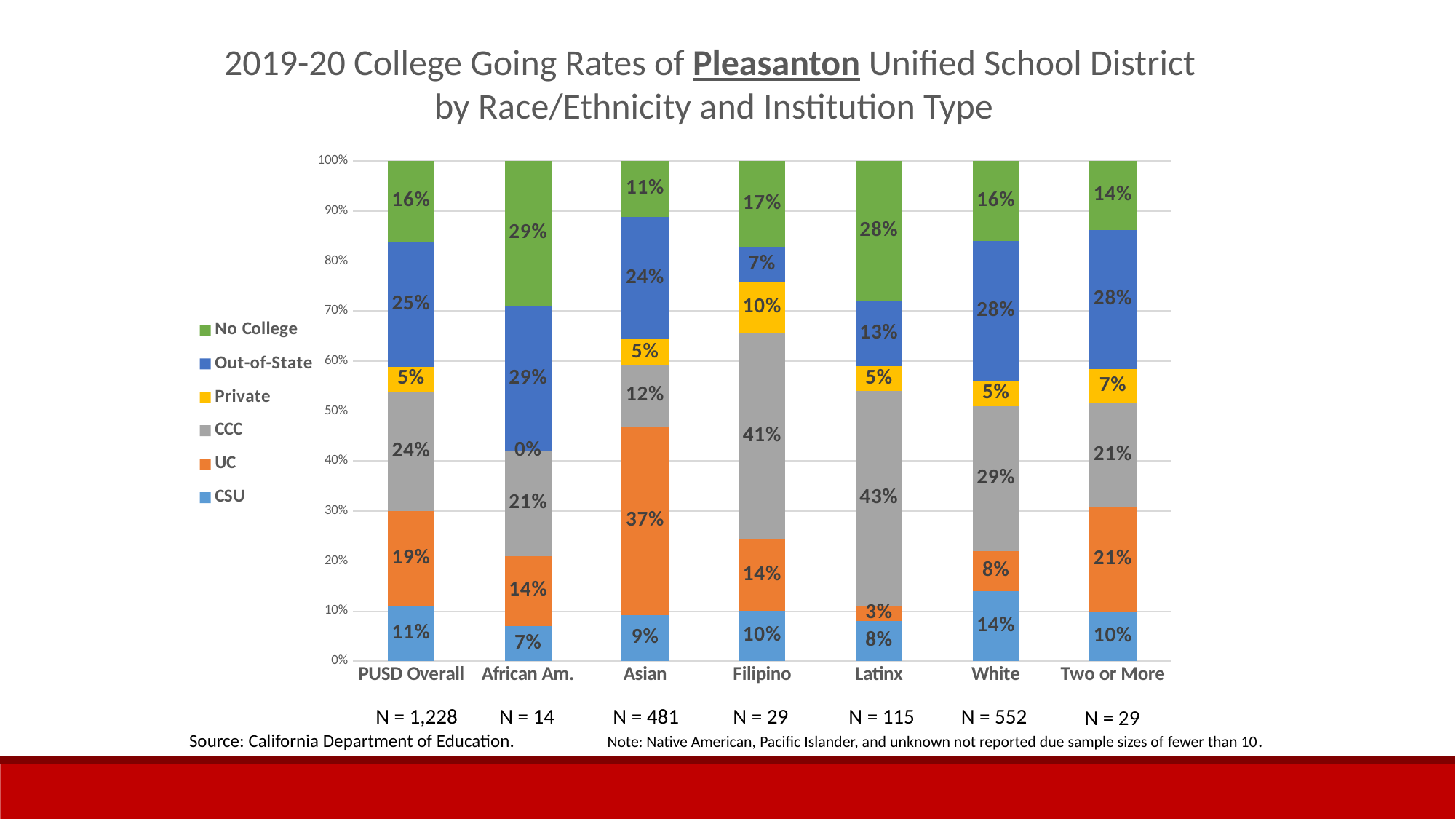
Which group has a larger UC percentage, White or Two or More? Two or More What percentage of Asian students went to a UC? 37% What is the difference between the No College percentage for Filipino students and for Asian students? 6 percentage points What is the CCC value for Latinx students? 43% Which race/ethnicity group has the lowest CSU percentage? African Am. Which race/ethnicity group has the highest No College percentage? African Am. How many institution-type series does the legend list? 6 What is the Private value for African Am. students? 0% What kind of chart is shown on the slide? Stacked bar chart What is the Out-of-State value for Filipino students? 7% What colour represents CCC in the legend? Gray How many race/ethnicity categories are shown on the x axis? 7